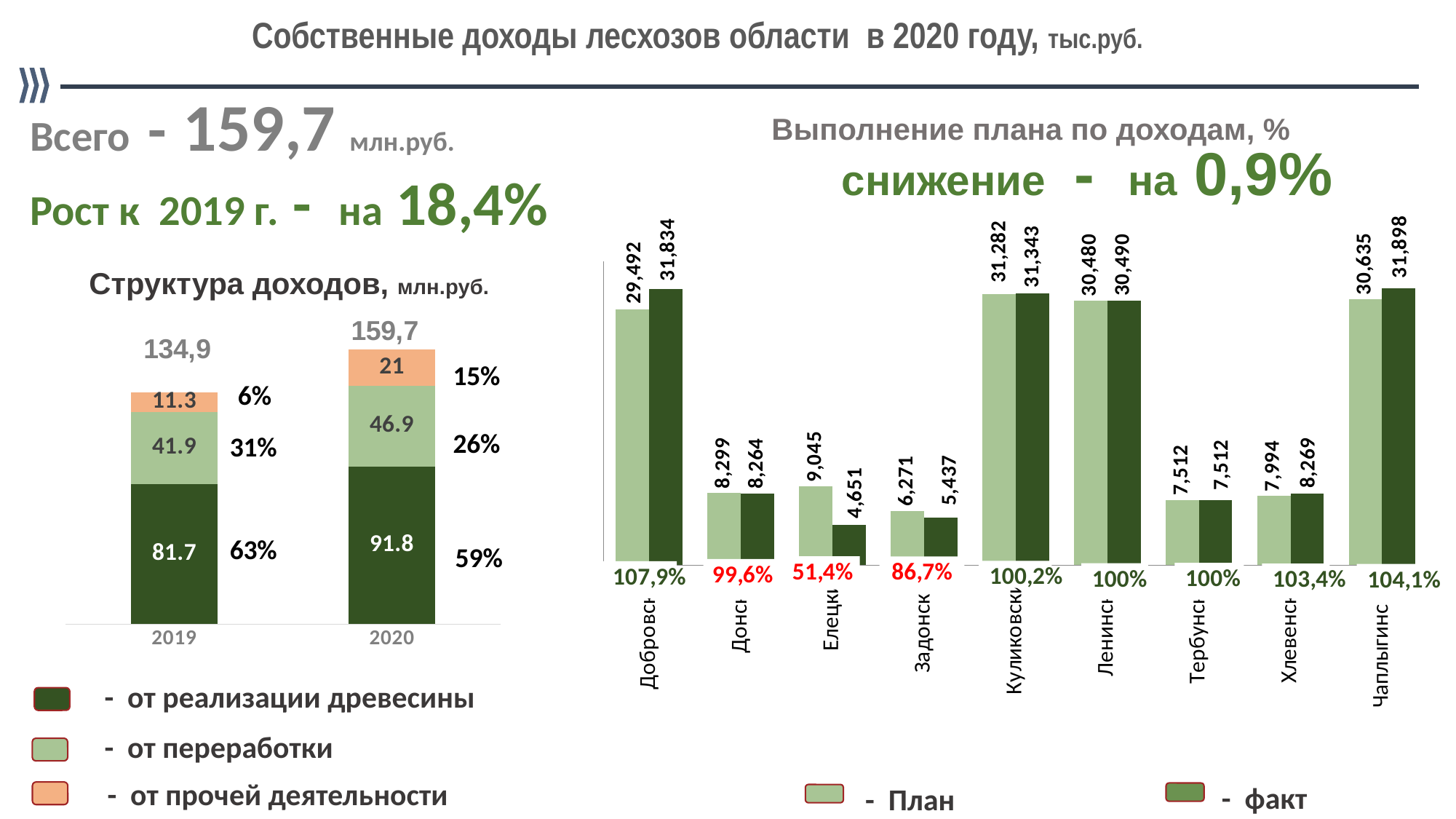
On the chart 'Структура доходов, млн.руб.', what is the value for 'от переработки' in 2019? 41.9 What kind of chart is 'Структура доходов, млн.руб.'? Stacked bar chart On the chart 'Структура доходов, млн.руб.', what share of the 2020 bar is 'от прочей деятельности'? 15% On the chart 'Структура доходов, млн.руб.', what is the total of the 2019 stacked bar? 134,9 On the chart 'Выполнение плана по доходам, %', how many districts are shown on the x axis? 9 On the chart 'Выполнение плана по доходам, %', which is larger for Задонск, 'План' or 'факт'? План On the chart 'Выполнение плана по доходам, %', which district has the lowest plan fulfilment percentage? Елецк (51,4%) On the chart 'Структура доходов, млн.руб.', how many series does the legend list? 3 On the chart 'Выполнение плана по доходам, %', what is the difference between 'План' and 'факт' for Задонск? 834 On the chart 'Структура доходов, млн.руб.', what is the value for 'от реализации древесины' in 2020? 91.8 On the chart 'Выполнение плана по доходам, %', what is the 'факт' value for Задонск? 5,437 On the chart 'Выполнение плана по доходам, %', what is the 'План' value for Задонск? 6,271